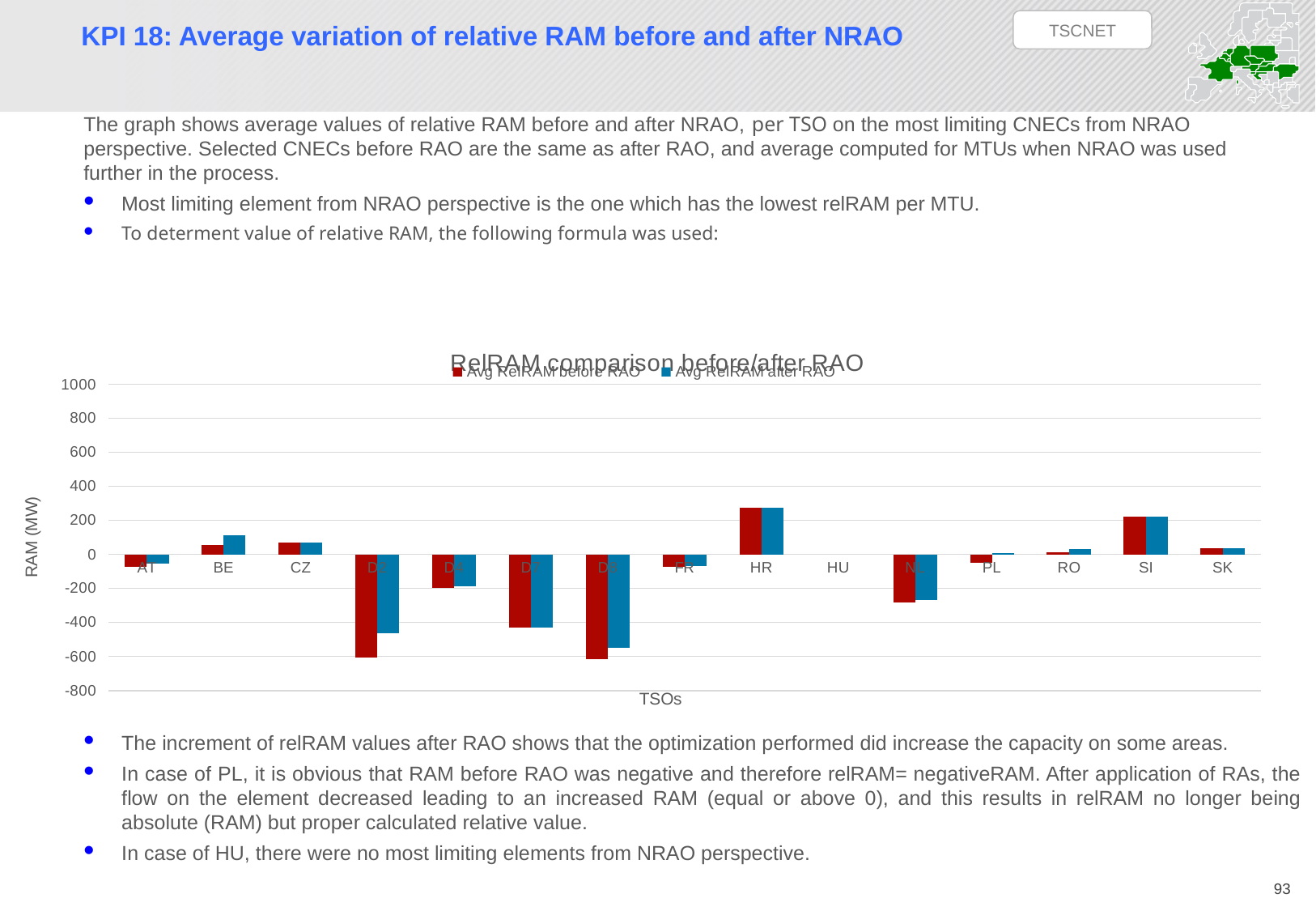
How many series does the legend of the chart list? 2 Which TSO has the highest Avg RelRAM before RAO? HR What is the title of the chart? RelRAM comparison before/after RAO For D2, which is larger: Avg RelRAM before RAO or Avg RelRAM after RAO? Avg RelRAM after RAO How many TSO categories are shown on the x axis of the chart? 15 What is the label of the vertical axis of the chart? RAM (MW) What kind of chart is shown on the slide? bar chart Which TSO has the lowest Avg RelRAM after RAO? D8 Is the Avg RelRAM before RAO for D2 greater or less than -400? less Is the Avg RelRAM before RAO for HR greater or less than 200? greater For BE, which is larger: Avg RelRAM before RAO or Avg RelRAM after RAO? Avg RelRAM after RAO Is the Avg RelRAM after RAO for NL greater or less than -200? less